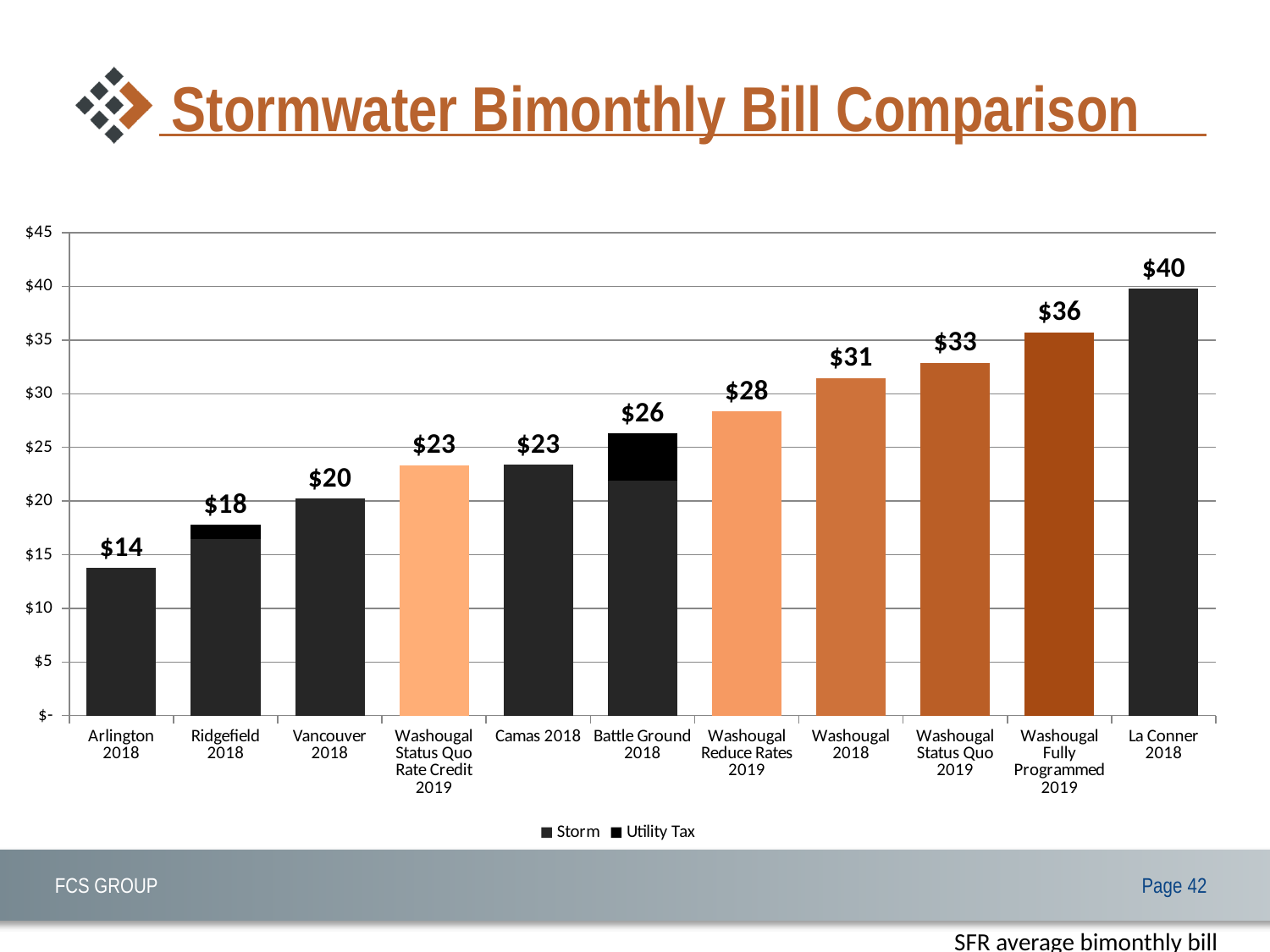
Which category has the highest total bimonthly bill? La Conner 2018 Which has a larger total bill, Washougal 2018 or Washougal Reduce Rates 2019? Washougal 2018 What is the total bimonthly bill shown for Arlington 2018? $14 Do the total bill values generally rise or fall from left to right along the x axis? Rise What is the total bimonthly bill shown for Washougal Fully Programmed 2019? $36 What is the difference between the total bill for La Conner 2018 and Arlington 2018? $26 How many series does the legend list? 2 Is the Storm portion of the Battle Ground 2018 bar greater or less than $25? less What kind of chart is shown on the slide? Stacked bar chart Which category has the lowest total bimonthly bill? Arlington 2018 What is the total bimonthly bill shown for Battle Ground 2018? $26 How many categories are shown on the x axis? 11